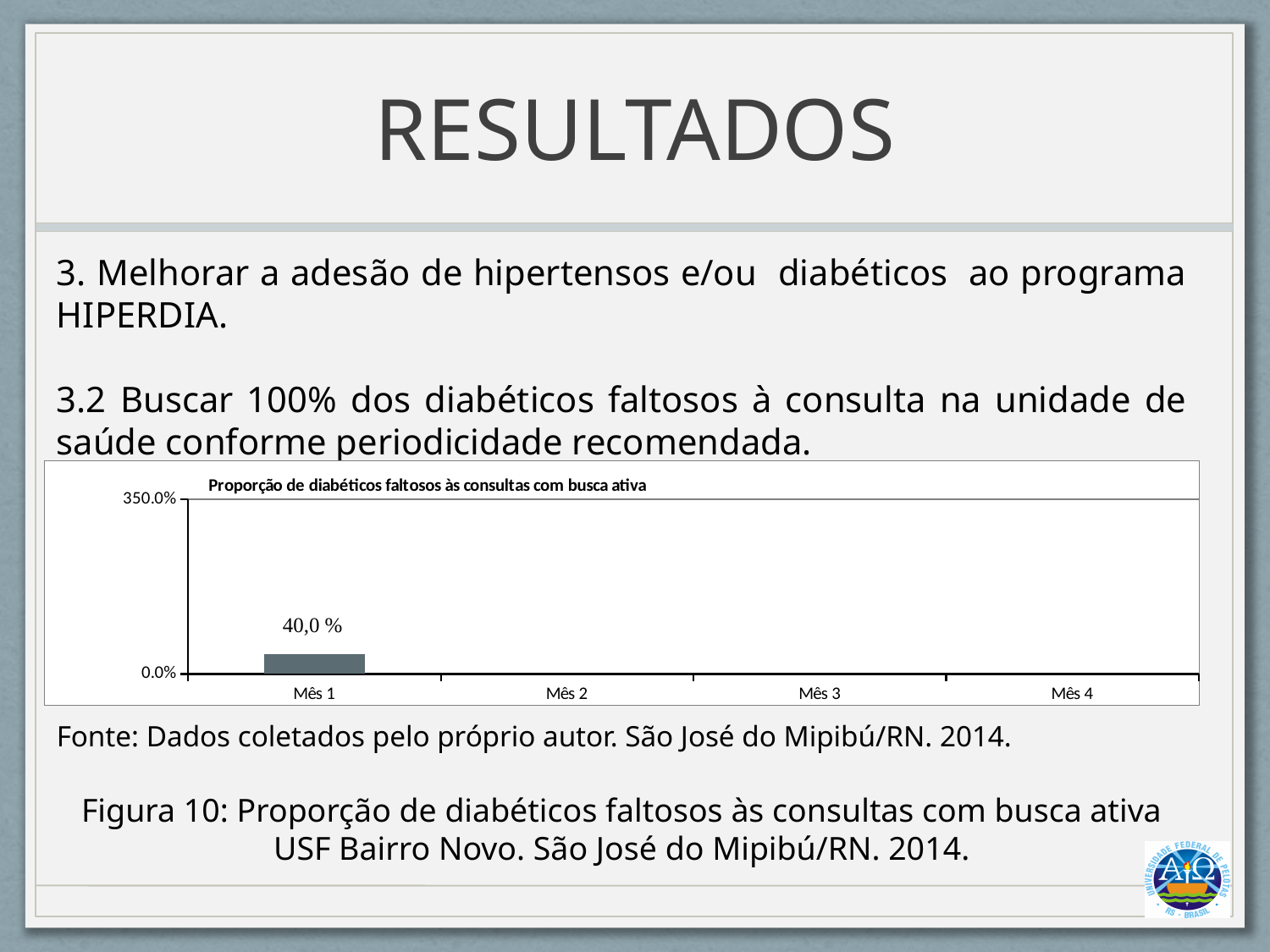
Is the value for Mês 1 greater or less than 350.0%? less Which month has the highest value in the chart? Mês 1 How many month categories are shown on the x axis of the chart? 4 What kind of chart is shown on the slide? bar chart How many of the months have a bar plotted in the chart? 1 What is the highest value labelled on the y axis of the chart? 350.0% What is the value shown for Mês 1 in the chart? 40,0 % What is the label of the first category on the x axis of the chart? Mês 1 What is the label of the last category on the x axis of the chart? Mês 4 What is the title of the chart? Proporção de diabéticos faltosos às consultas com busca ativa